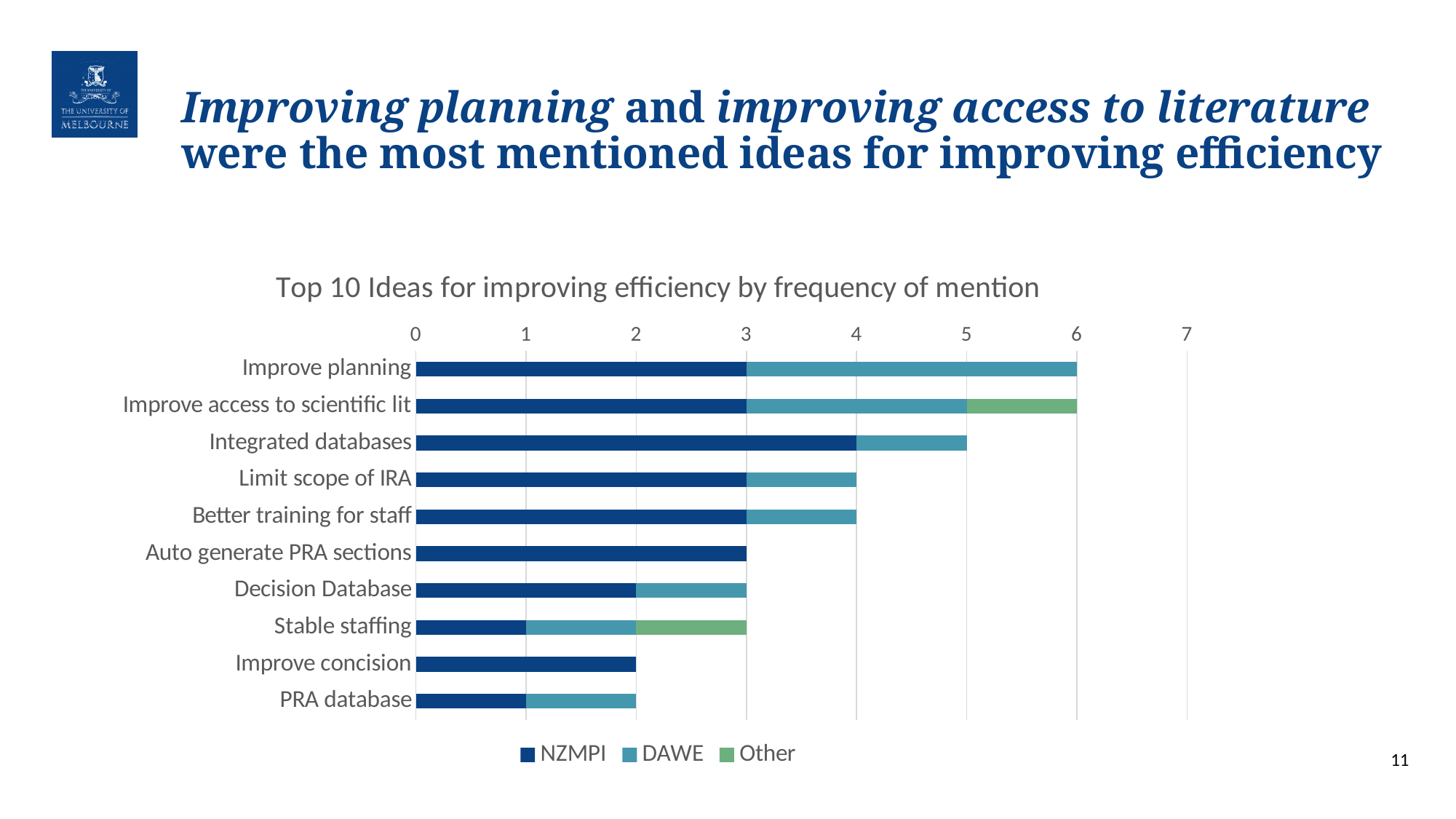
What kind of chart is shown on the slide? bar chart What is the total frequency of mention for Improve planning? 6 How many ideas (categories) are listed on the chart? 10 What is the title of the chart? Top 10 Ideas for improving efficiency by frequency of mention Which has a larger total: Integrated databases or Limit scope of IRA? Integrated databases What is the difference between the total for Improve planning and the total for Improve concision? 4 How many series does the legend list? 3 Which idea has the highest NZMPI value? Integrated databases What is the total frequency of mention for Integrated databases? 5 What is the Other value for Improve access to scientific lit? 1 What is the NZMPI value for Integrated databases? 4 Is the total for Improve planning greater or less than 5? greater